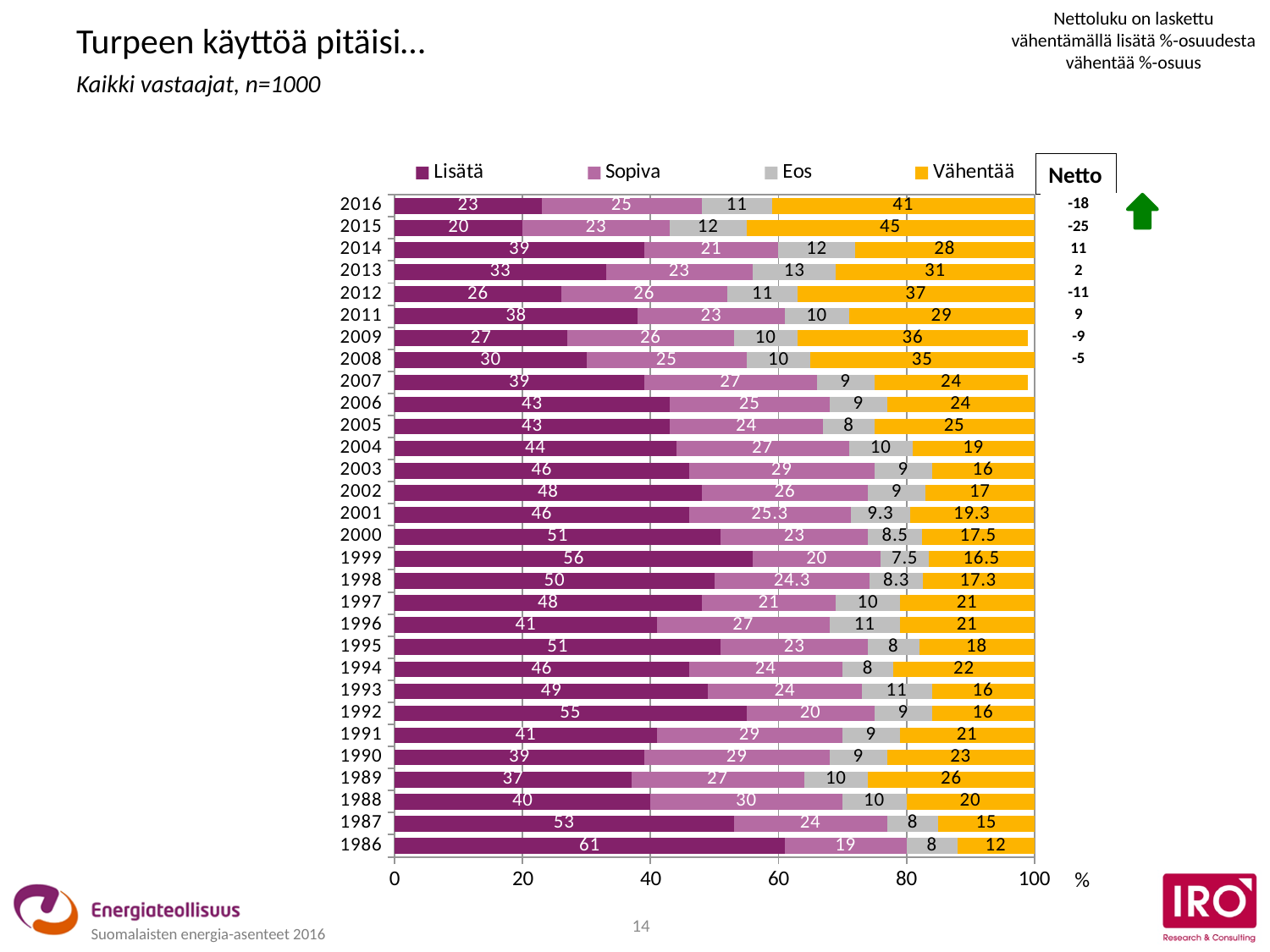
What type of chart is shown on the slide? Stacked bar chart What is the Sopiva value for 1988? 30 In which year is the Lisätä share the highest? 1986 In 2014, which is larger: the Lisätä share or the Vähentää share? Lisätä How many series does the legend list? 4 How many years are shown in the chart? 30 What is the Eos value for 2001? 9.3 What percentage of respondents chose Lisätä in 2016? 23 In 2016, how much larger is the Vähentää share than the Lisätä share? 18 What is the Netto value shown for 2016? -18 In which year is the Lisätä share the lowest? 2015 What is the Vähentää share for 2015? 45